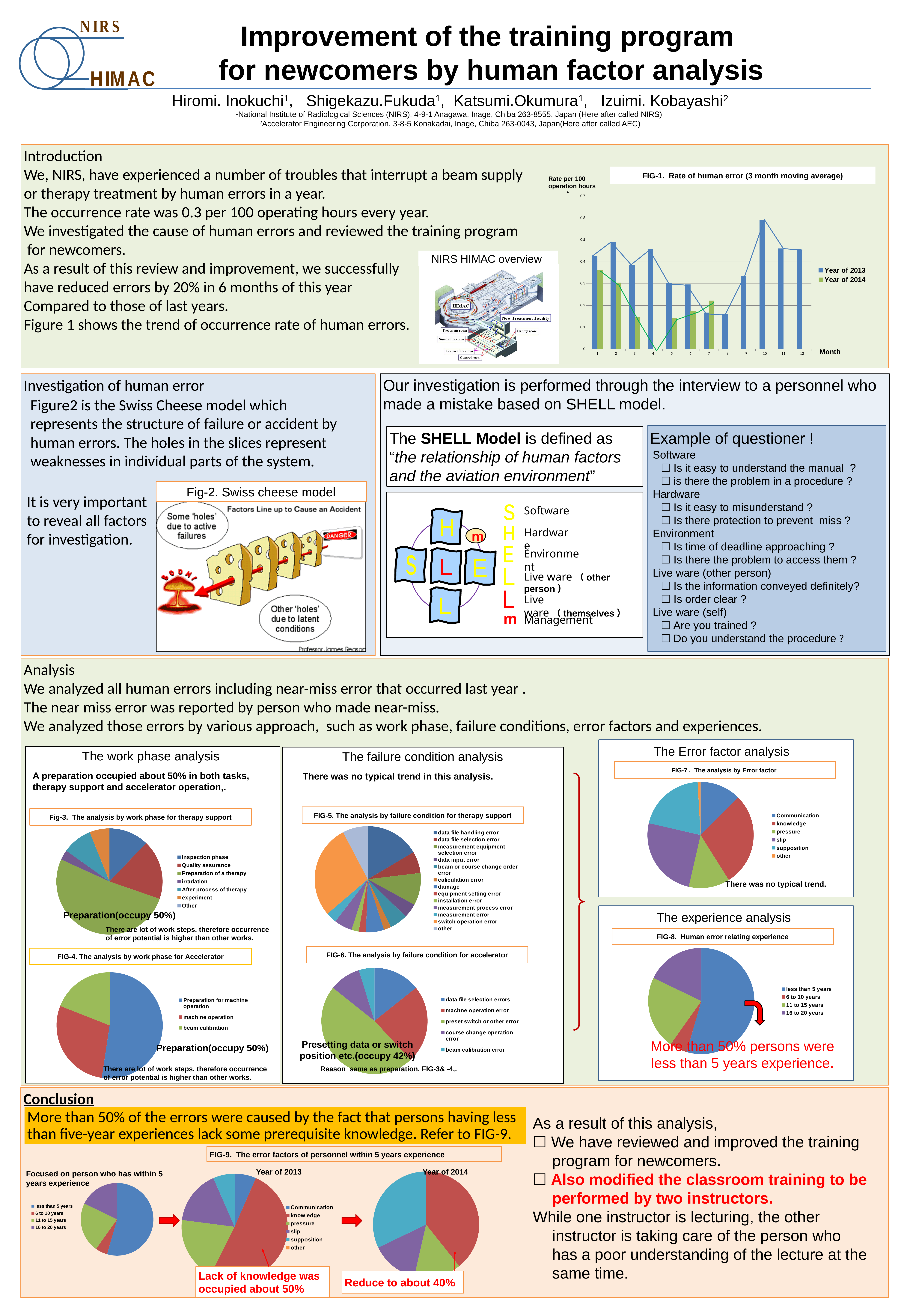
In FIG-7 (The analysis by Error factor), which category has the smallest slice? other What kind of chart is Fig-3 (The analysis by work phase for therapy support)? pie chart In FIG-1 (Rate of human error), how many series does the legend list? 2 In FIG-1 (Rate of human error), is the Year of 2013 value for month 8 greater or less than 0.2? less In FIG-1 (Rate of human error), which month has the highest bar for Year of 2013? 10 In FIG-1 (Rate of human error), what are the two legend entries? Year of 2013, Year of 2014 In FIG-4 (work phase for Accelerator), how many categories does the legend list? 3 In FIG-8 (Human error relating experience), which category has the largest slice? less than 5 years In FIG-4 (work phase for Accelerator), what share of the pie does Preparation occupy? 50% In Fig-3 (work phase for therapy support), how many categories does the legend list? 7 In FIG-1 (Rate of human error), is the Year of 2013 value for month 10 greater or less than 0.5? greater In FIG-1 (Rate of human error), is the Year of 2014 value for month 4 greater or less than 0.1? less